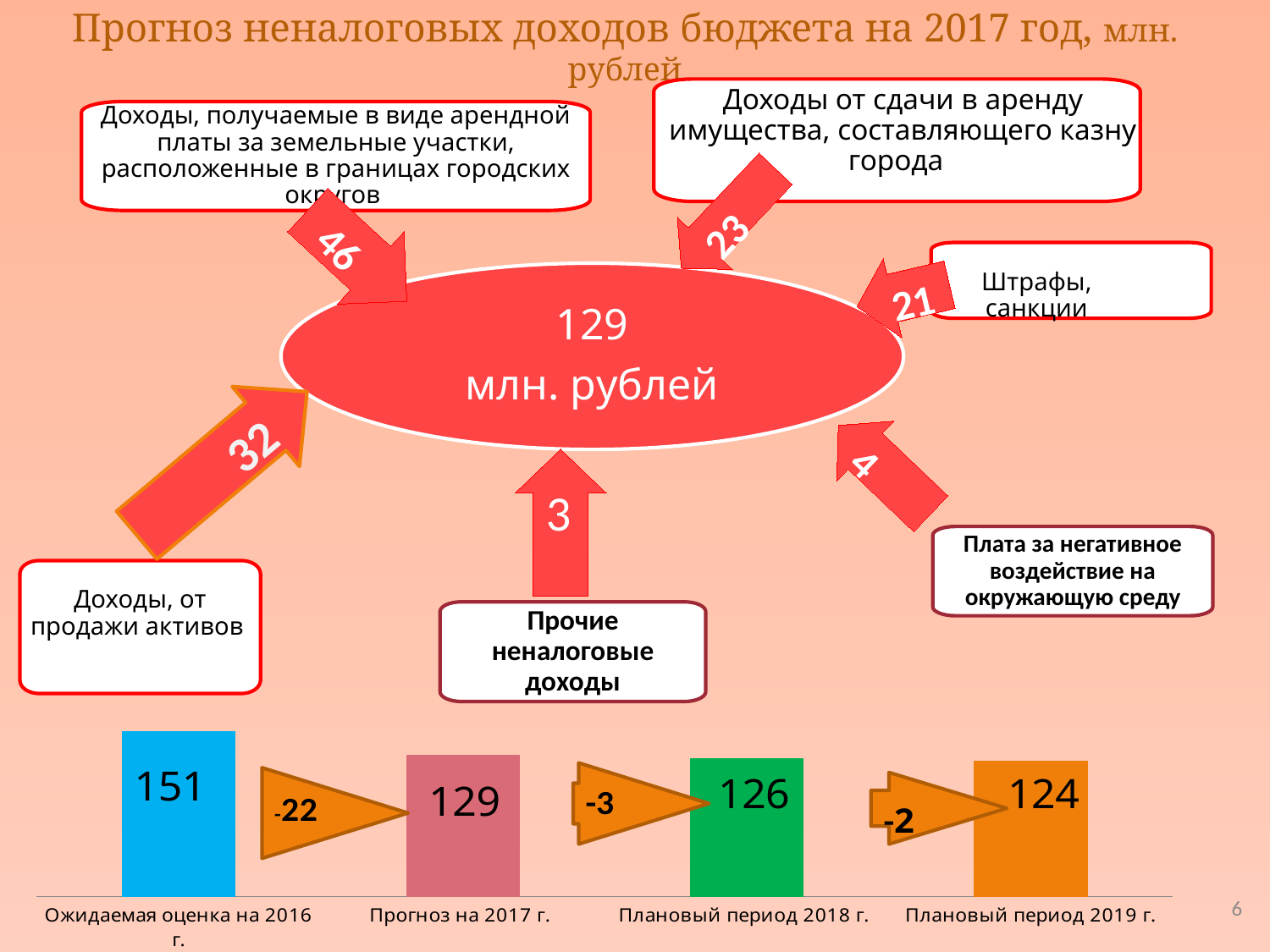
In the bar chart at the bottom, do the values rise or fall from left to right? fall In the bar chart at the bottom, what is the difference between the value for "Ожидаемая оценка на 2016 г." and the value for "Прогноз на 2017 г."? 22 What kind of chart is shown at the bottom of the slide? bar chart In the bar chart at the bottom, which is larger: the value for "Прогноз на 2017 г." or the value for "Плановый период 2018 г."? Прогноз на 2017 г. In the bar chart at the bottom, which category has the highest value? Ожидаемая оценка на 2016 г. How many bars are in the bar chart at the bottom of the slide? 4 In the bar chart at the bottom, what is the value for "Плановый период 2018 г."? 126 In the bar chart at the bottom, what is the value for "Прогноз на 2017 г."? 129 In the bar chart at the bottom, what is the difference between the value for "Плановый период 2018 г." and the value for "Плановый период 2019 г."? 2 In the bar chart at the bottom, what is the value for "Плановый период 2019 г."? 124 In the bar chart at the bottom, what is the value for "Ожидаемая оценка на 2016 г."? 151 In the bar chart at the bottom, which category has the lowest value? Плановый период 2019 г.